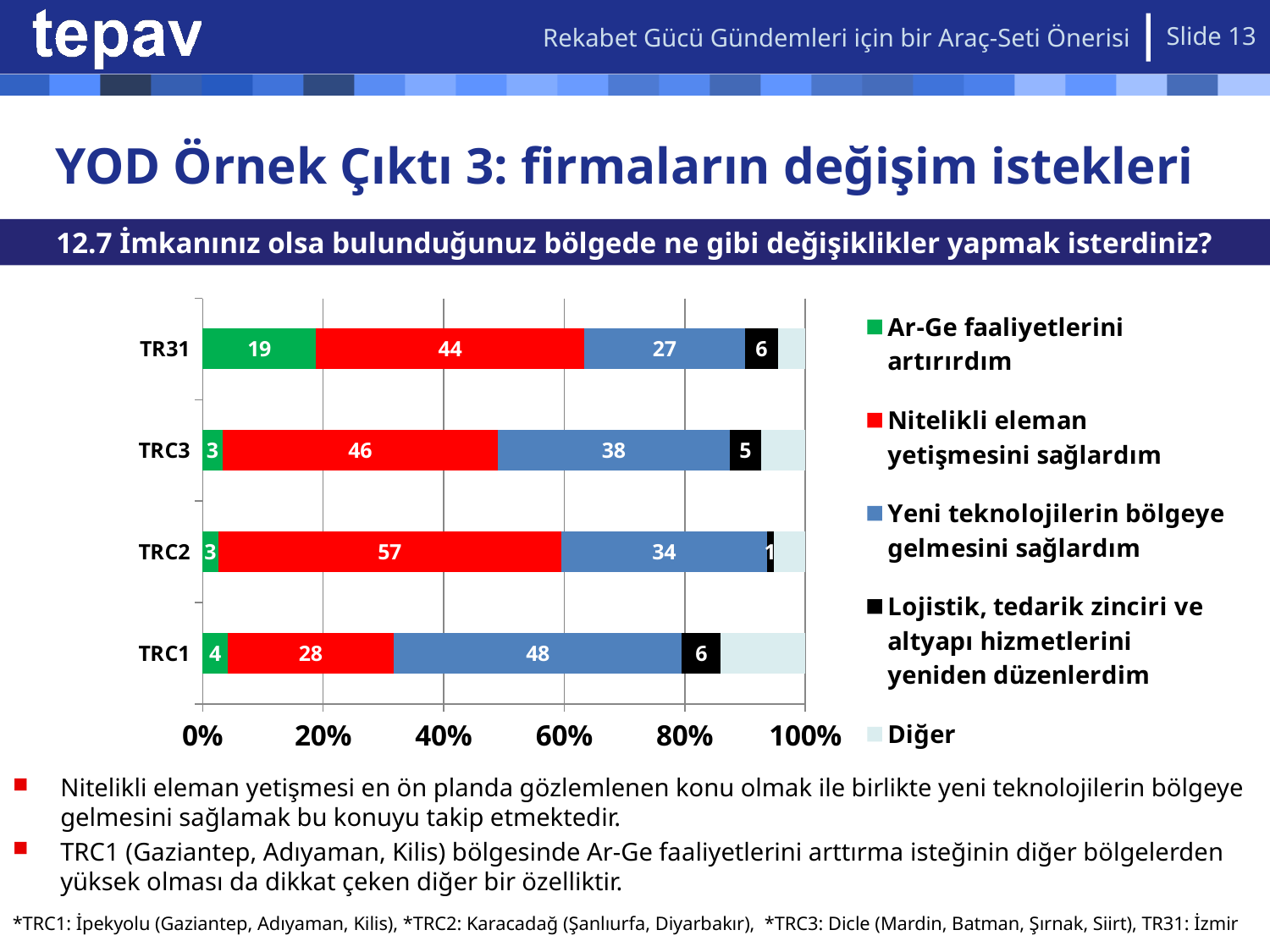
Which region has the highest value for 'Nitelikli eleman yetişmesini sağlardım'? TRC2 How many regions are shown on the chart? 4 Which region has the lowest value for 'Yeni teknolojilerin bölgeye gelmesini sağlardım'? TR31 What is the difference between the 'Nitelikli eleman yetişmesini sağlardım' values for TRC2 and TRC1? 29 What is the value for 'Nitelikli eleman yetişmesini sağlardım' in the TR31 bar? 44 What is the value for 'Lojistik, tedarik zinciri ve altyapı hizmetlerini yeniden düzenlerdim' in the TRC2 bar? 1 How many series does the legend list? 5 What kind of chart is shown on the slide? Stacked bar chart Which is larger: the 'Ar-Ge faaliyetlerini artırırdım' value for TR31 or for TRC1? TR31 What is the value for 'Yeni teknolojilerin bölgeye gelmesini sağlardım' in the TRC1 bar? 48 Which legend entry is shown in red? Nitelikli eleman yetişmesini sağlardım What is the value for 'Ar-Ge faaliyetlerini artırırdım' in the TR31 bar? 19